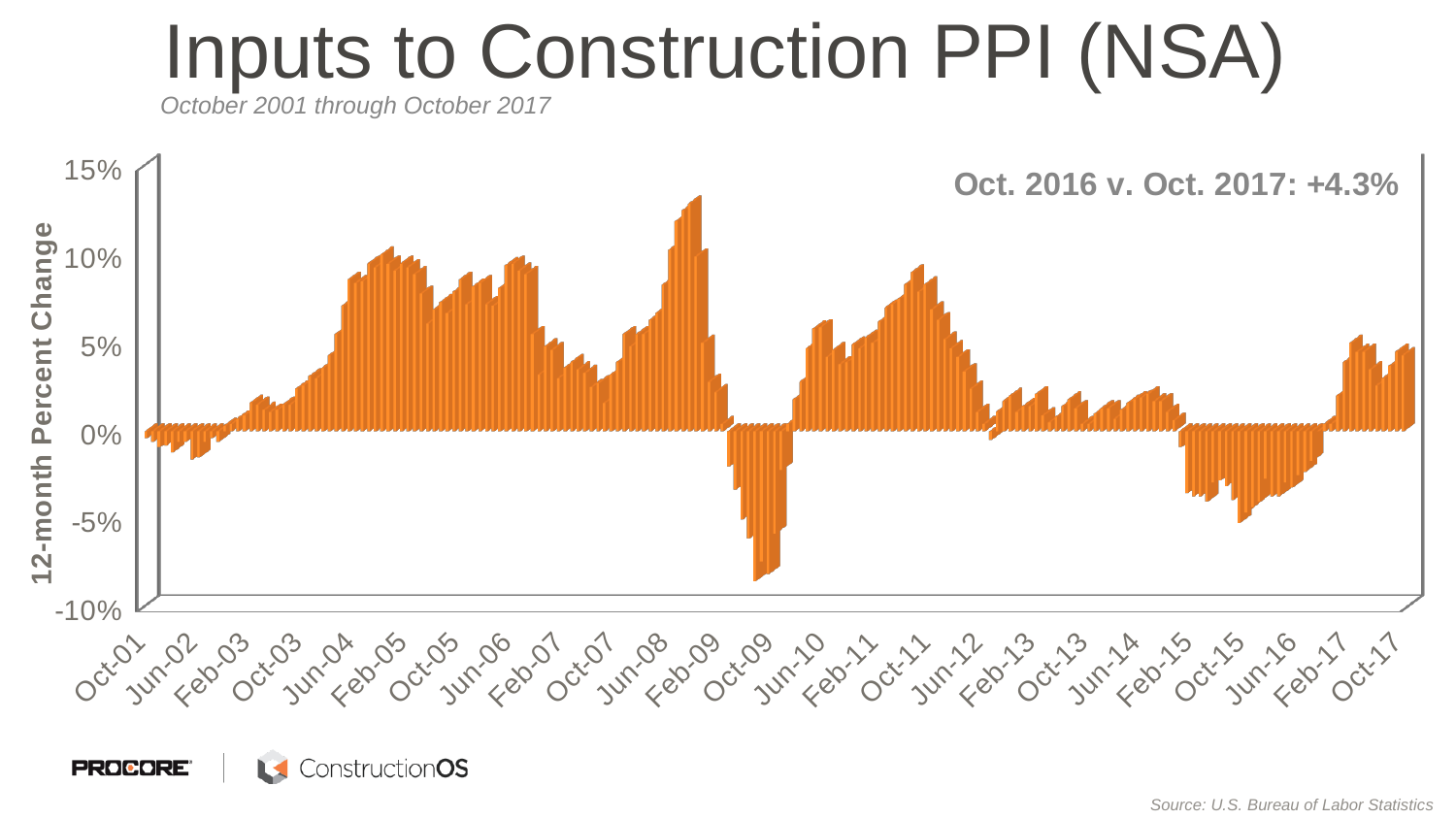
What is the 12-month percent change for Oct. 2016 v. Oct. 2017 as stated on the slide? +4.3% Is the value for Oct-15 greater or less than 0%? less What is the title of the chart? Inputs to Construction PPI (NSA) Is the highest value on the chart greater or less than 10%? greater Do the values rise or fall from Oct-15 to Feb-17? rise What is the label on the vertical axis? 12-month Percent Change What is the highest tick value shown on the vertical axis? 15% Is the value for Feb-05 greater or less than 5%? greater Which is larger, the value for Feb-05 or the value for Oct-09? Feb-05 What kind of chart is shown on the slide? bar chart